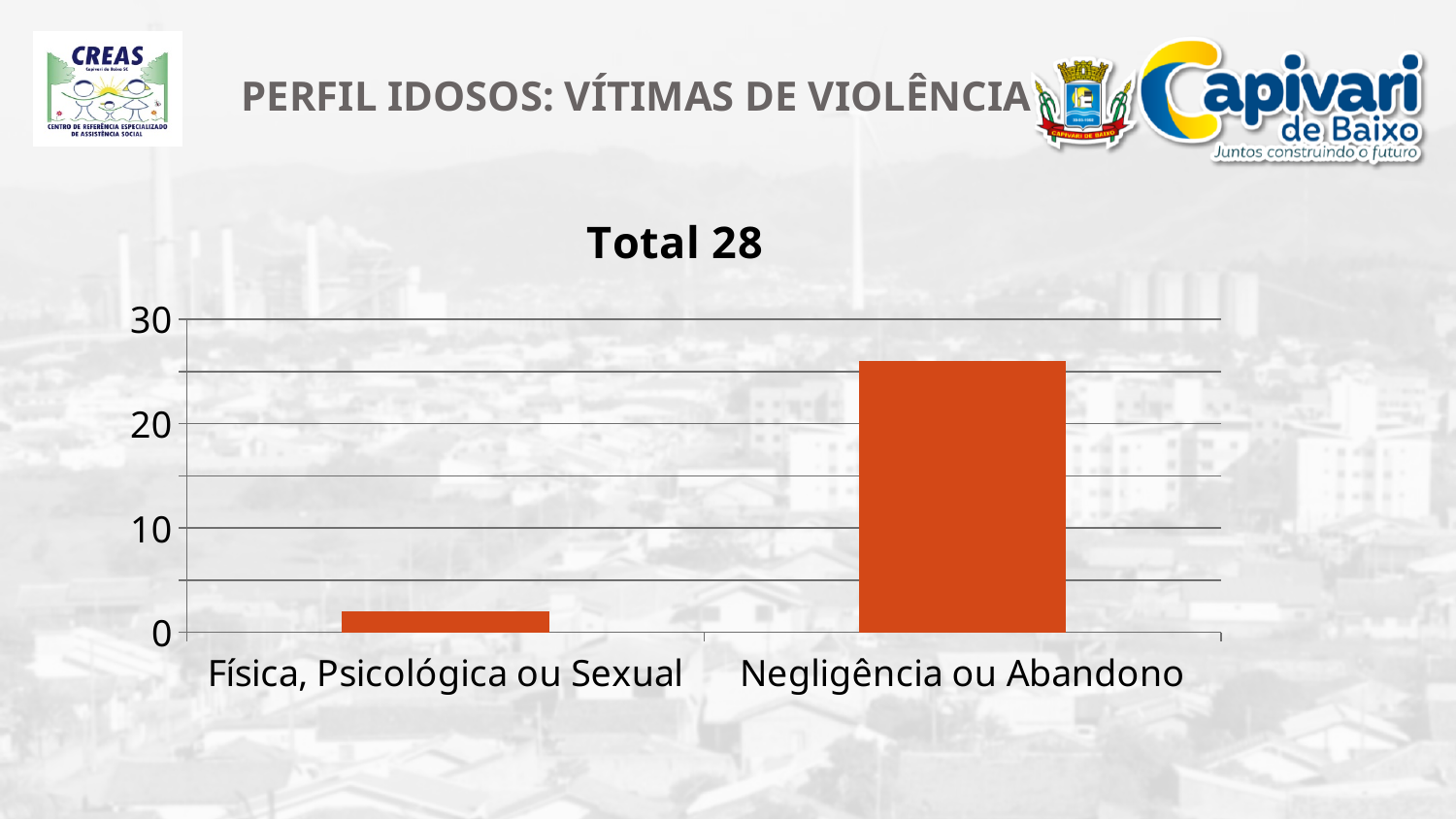
What is the highest value labelled on the vertical axis of the chart? 30 What is the title of the chart? Total 28 Which is larger: the value for Física, Psicológica ou Sexual or the value for Negligência ou Abandono? Negligência ou Abandono Which category has the highest value in the chart? Negligência ou Abandono Is the value for Física, Psicológica ou Sexual greater or less than 10? less How many categories are shown on the x axis of the chart? 2 Is the value for Negligência ou Abandono greater or less than 30? less What type of chart is shown on the slide? bar chart Is the value for Negligência ou Abandono greater or less than 20? greater Which category has the lowest value in the chart? Física, Psicológica ou Sexual